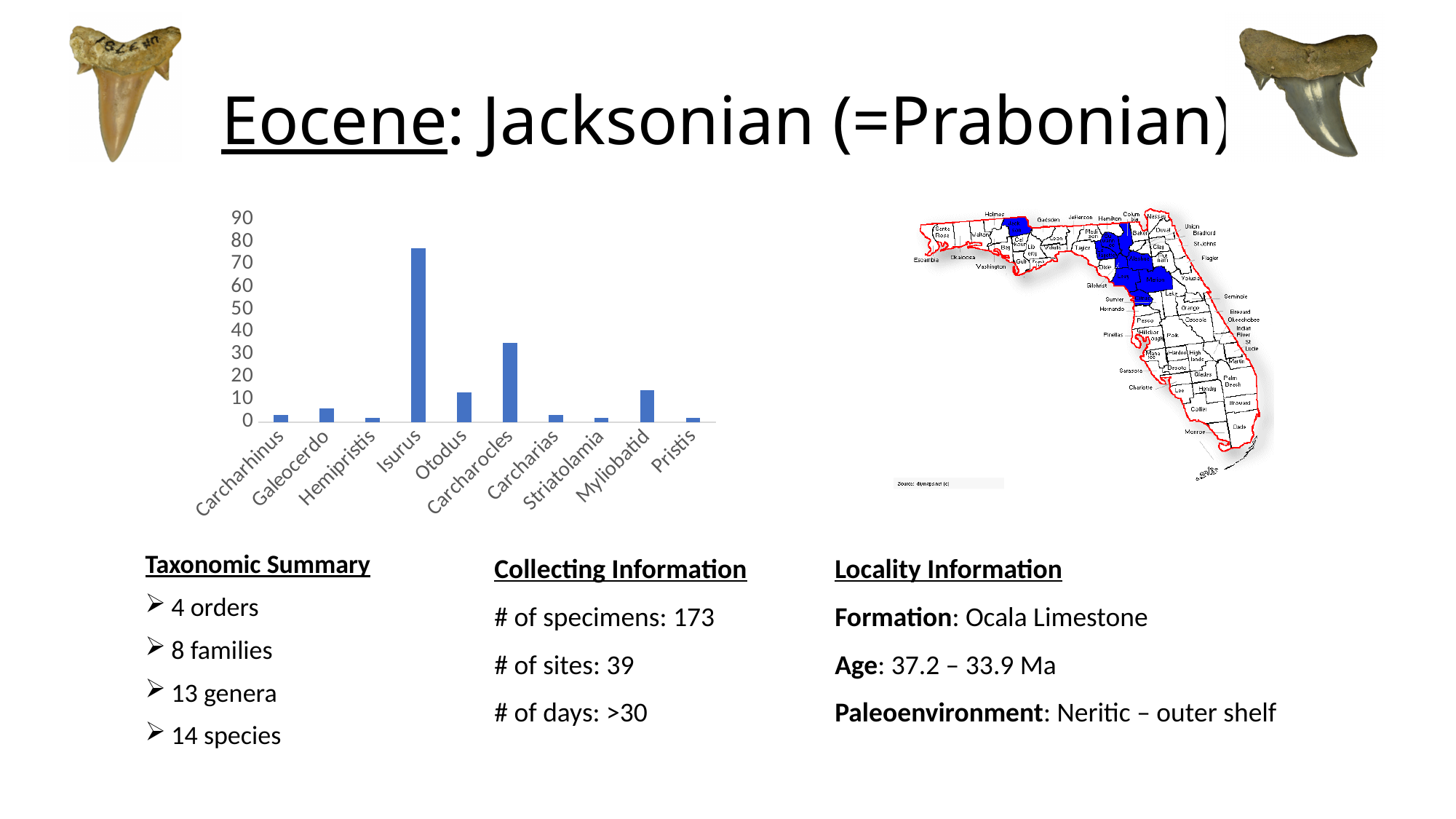
What is the highest value labelled on the y axis of the bar chart? 90 How many categories (taxa) are shown on the x axis of the bar chart? 10 Is the value for Carcharocles greater or less than 30? greater Is the value for Myliobatid greater or less than 10? greater Which has the larger value, Myliobatid or Galeocerdo? Myliobatid Is the value for Carcharocles greater or less than 40? less Which taxon has the highest bar in the chart? Isurus Which has the larger value, Carcharocles or Otodus? Carcharocles What kind of chart is shown on the slide? bar chart Which has the larger value, Isurus or Carcharocles? Isurus